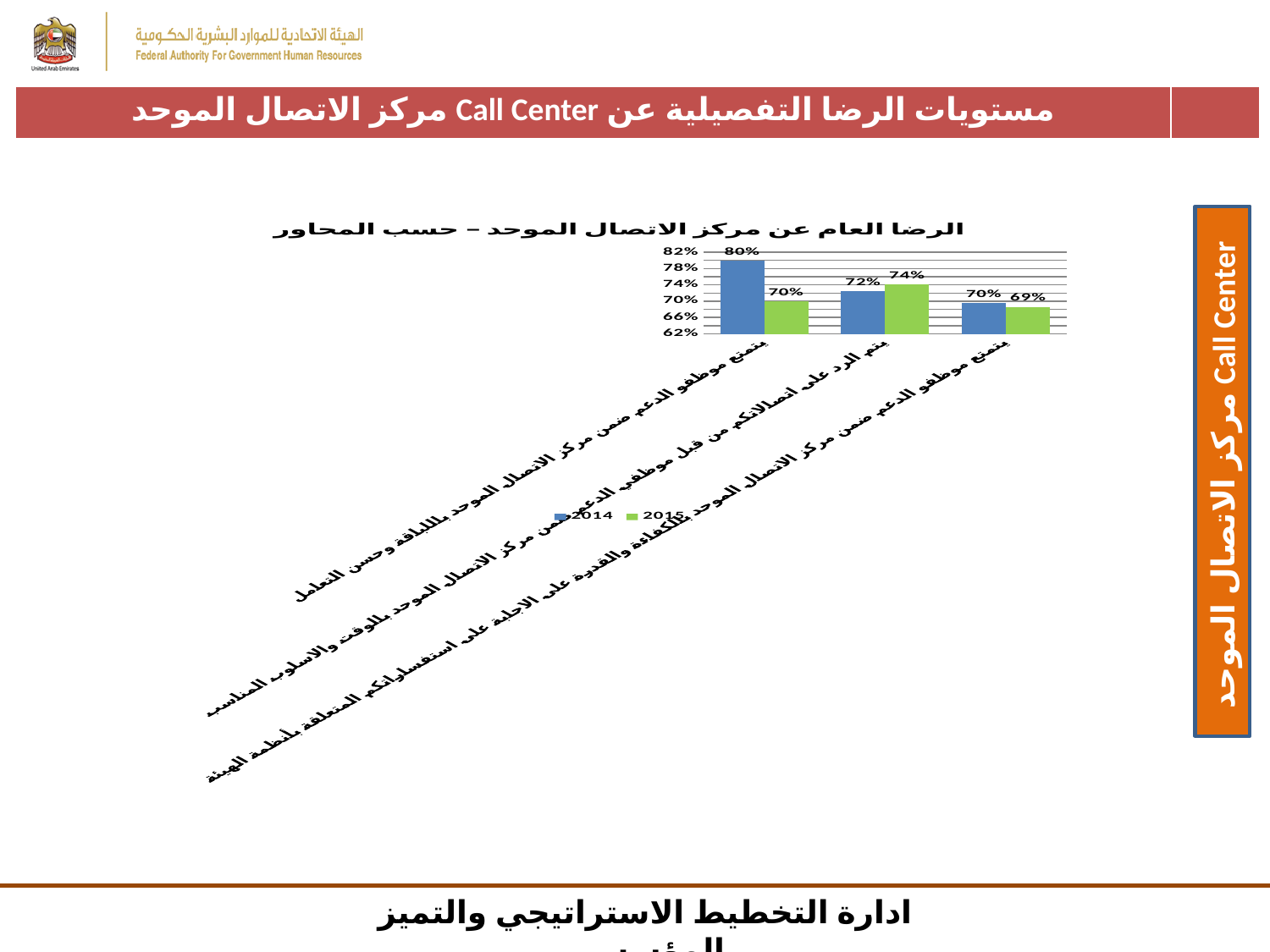
Which years are listed in the chart legend? 2014 and 2015 What type of chart is shown on the slide? bar chart What is the 2015 value for the leftmost category (باللباقة وحسن التعامل)? 70% For the middle category (يتم الرد على اتصالاتكم), which year has the larger value, 2014 or 2015? 2015 What is the 2015 value for the middle category (يتم الرد على اتصالاتكم بالوقت والأسلوب المناسب)? 74% What is the title of the chart? الرضا العام عن مركز الاتصال الموحد – حسب المحاور How many series does the chart legend list? 2 How many categories (axes/محاور) are plotted in the chart? 3 Which category has the highest 2014 value? the leftmost category (باللباقة وحسن التعامل) What is the 2014 value for the rightmost category (الكفاءة والقدرة على الاجابة على استفساراتكم)? 70% What is the difference between the 2014 and 2015 values for the leftmost category (باللباقة وحسن التعامل)? 10% What is the 2014 value for the leftmost category (باللباقة وحسن التعامل)? 80%